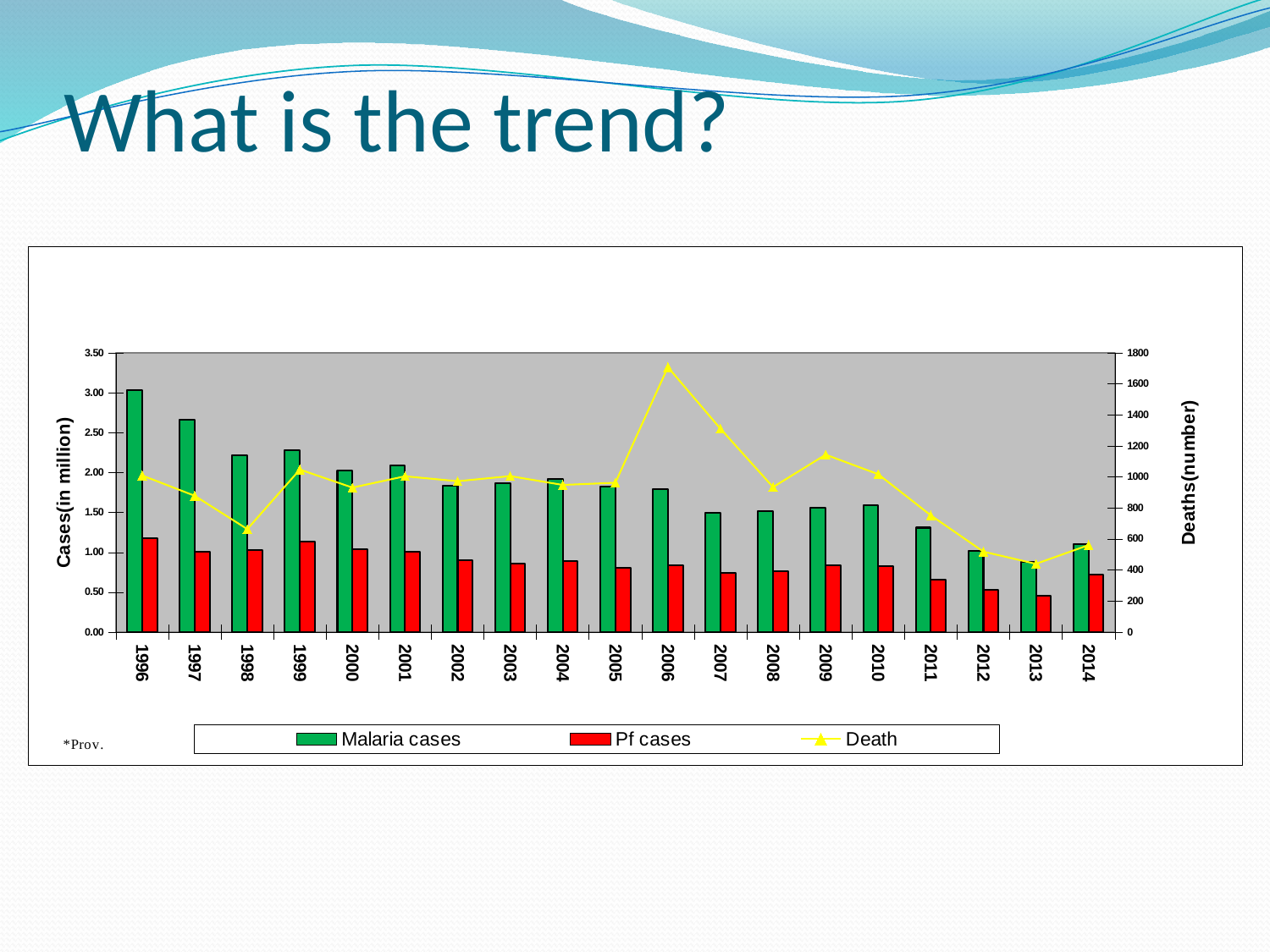
Is the value for Pf cases in 2012 greater or less than 1.00? less Is the value for Malaria cases in 1996 greater or less than 2.50? greater Which is larger, Malaria cases in 1997 or Malaria cases in 1998? 1997 What kind of chart is this? Combination bar and line chart What are the three series named in the legend? Malaria cases, Pf cases, Death In which year does the Death line reach its peak? 2006 Do Malaria cases generally rise or fall from 1996 to 2014? fall Which year has the lowest Malaria cases? 2013 How many years are shown on the x axis? 19 Which year has the highest Malaria cases? 1996 Is the value for Death in 2006 greater or less than 1600? greater How many series does the legend list? 3